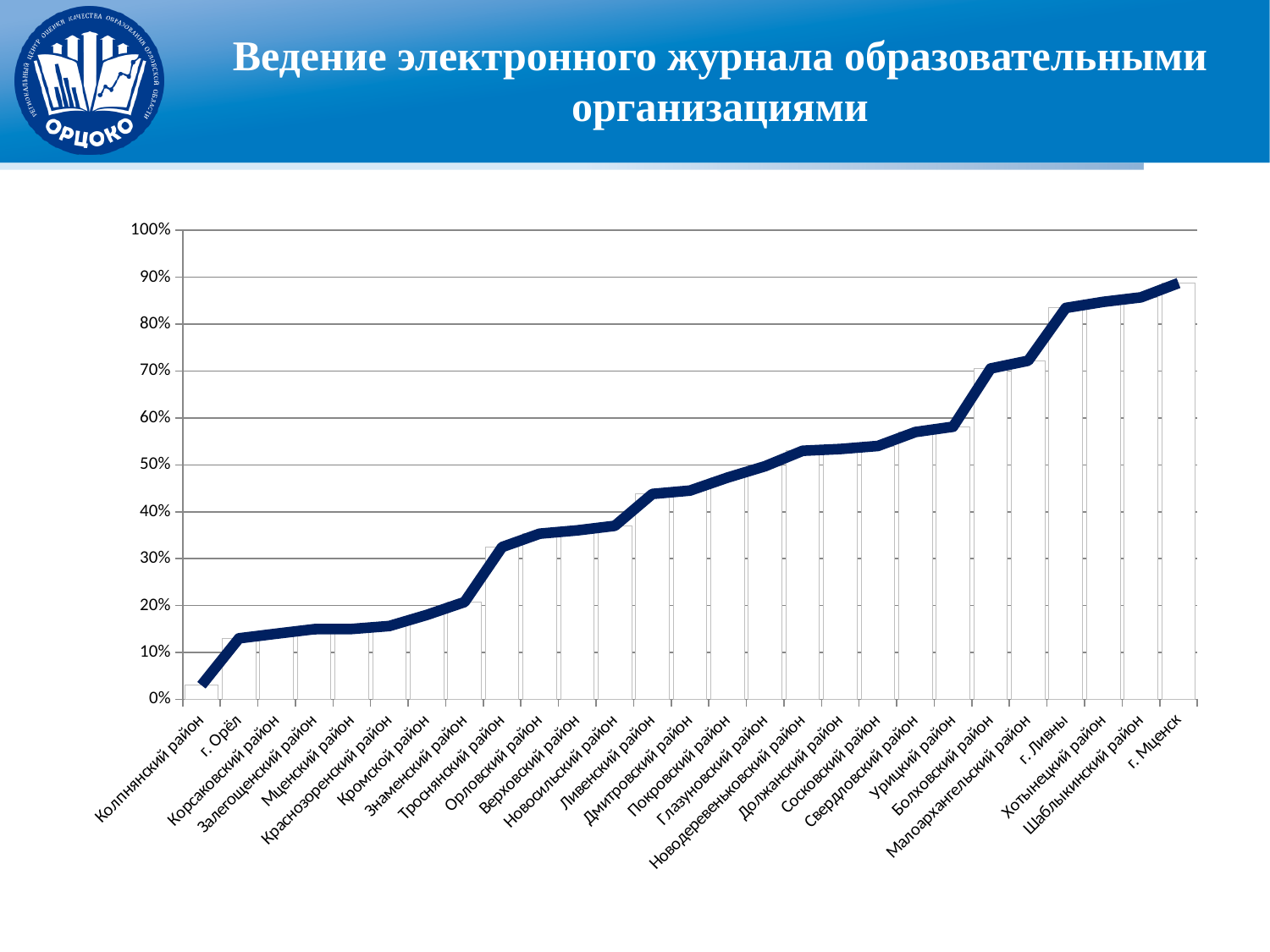
Is the value for г. Мценск greater or less than 90%? less Is the value for г. Ливны greater or less than 80%? greater Do the values rise or fall moving from left to right along the x axis? rise Which category has the lowest value on the chart? Колпнянский район What is the title of the slide containing the chart? Ведение электронного журнала образовательными организациями Which has the larger value, г. Ливны or Должанский район? г. Ливны Which category has the highest value on the chart? г. Мценск Is the value for г. Орёл greater or less than 10%? greater How many categories are shown along the x axis? 27